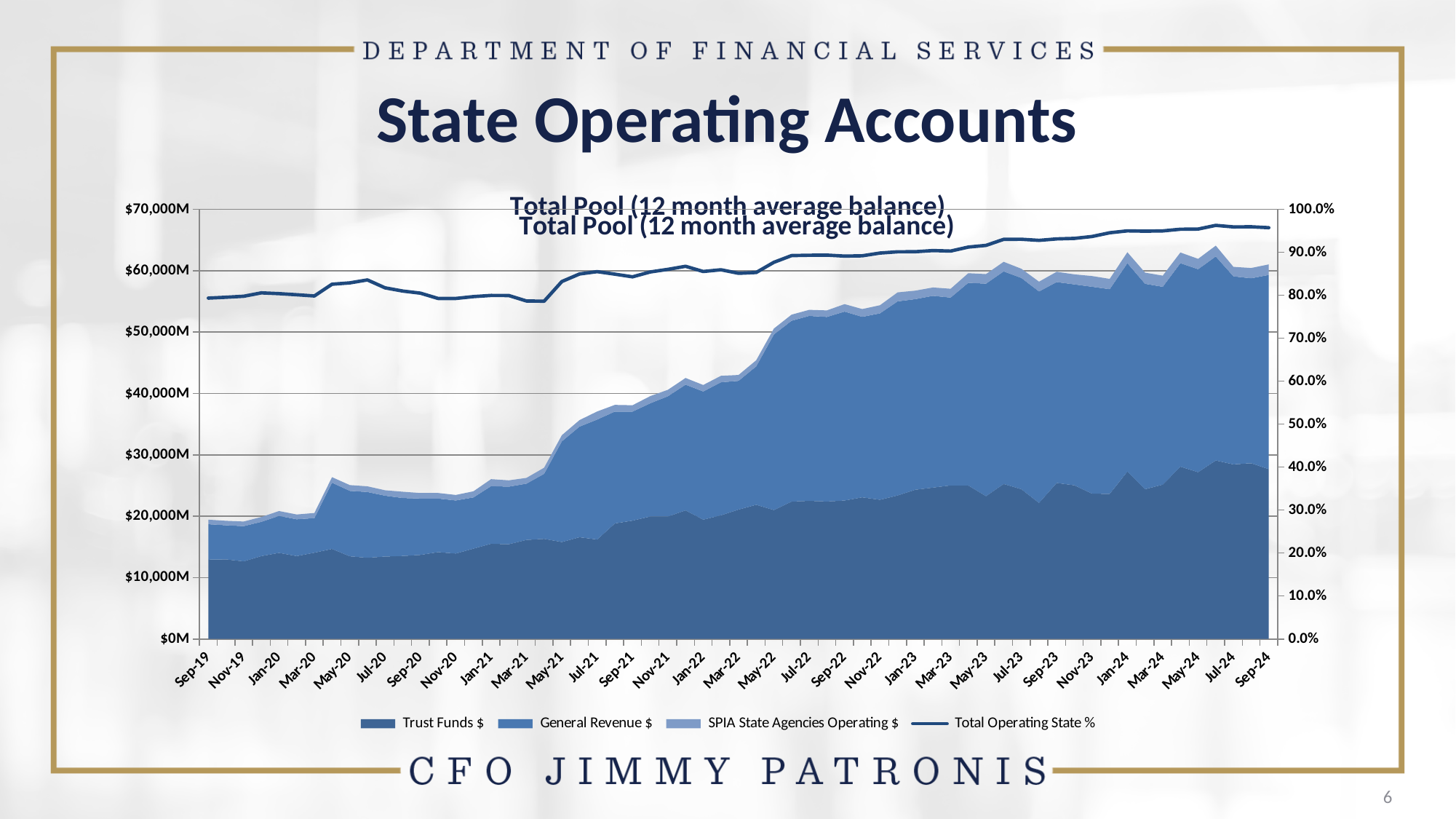
Is the Total Operating State % at Sep-24 greater or less than 90.0%? greater Which series is plotted as a line rather than an area? Total Operating State % Is the total stacked balance at Sep-19 greater or less than $20,000M? less Is the total stacked balance at Mar-21 greater or less than $30,000M? less Does the total stacked balance rise or fall overall from Sep-19 to Sep-24? rise Does the Total Operating State % line rise or fall overall from Sep-19 to Sep-24? rise What kind of chart is shown on the slide? stacked area chart with a line What is the title of the chart? Total Pool (12 month average balance) How many series does the legend list? 4